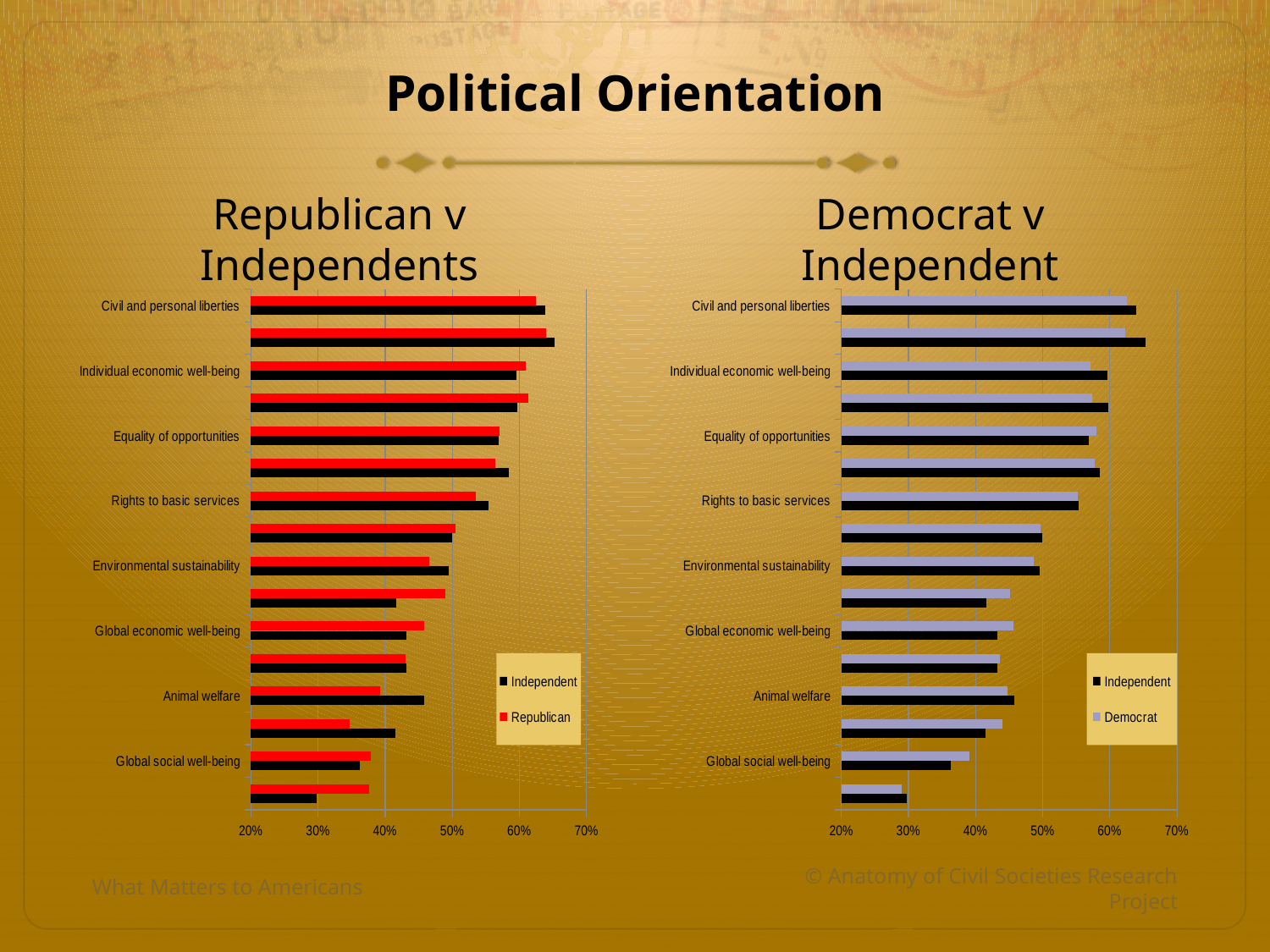
In the 'Democrat v Independent' chart, what colour are the Democrat bars? light blue In the 'Republican v Independents' chart, for Animal welfare, which series has the larger value, Independent or Republican? Independent What kind of chart is the 'Republican v Independents' chart? bar chart How many series does the legend of the 'Democrat v Independent' chart list? 2 In the 'Democrat v Independent' chart, do the bars generally get longer or shorter going from the top category down to the bottom category? shorter In the 'Republican v Independents' chart, which two series are shown in the legend? Independent and Republican In the 'Republican v Independents' chart, is the Independent value for Civil and personal liberties greater or less than 60%? greater In the 'Democrat v Independent' chart, is the Democrat value for Civil and personal liberties greater or less than 60%? greater In the 'Republican v Independents' chart, is the Republican value for Global social well-being greater or less than 40%? less